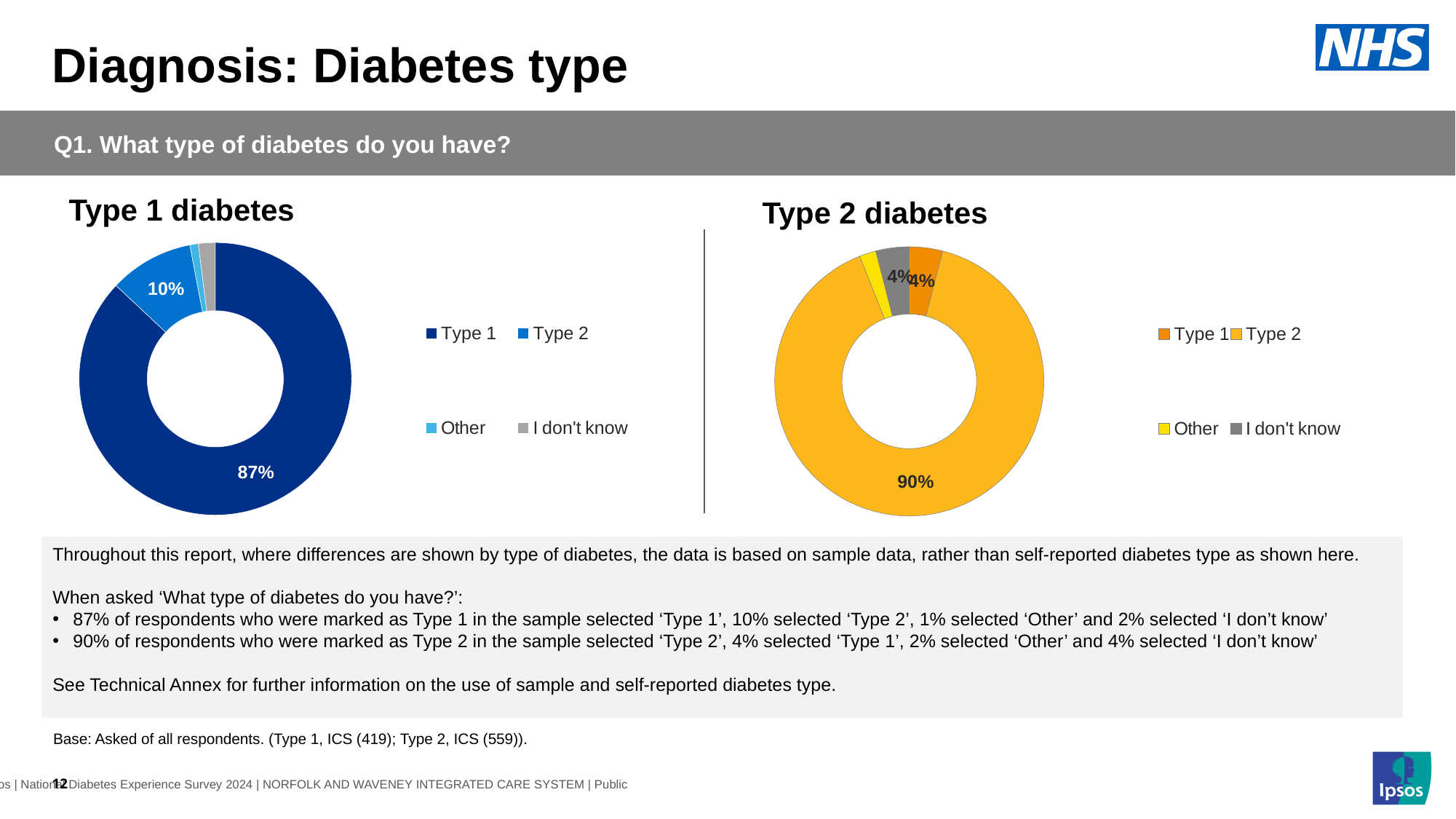
In the 'Type 1 diabetes' chart, what percentage selected 'Type 1'? 87% In the 'Type 1 diabetes' chart, what is the difference between the 'Type 1' and 'Type 2' shares? 77% How many categories does the legend of the 'Type 2 diabetes' chart list? 4 In the 'Type 1 diabetes' chart, which is larger: the 'Type 2' share or the 'Other' share? Type 2 In the 'Type 2 diabetes' chart, what is the difference between the 'Type 2' and 'Type 1' shares? 86% In the 'Type 2 diabetes' chart, what percentage selected 'Type 1'? 4% In the 'Type 1 diabetes' chart, what percentage selected 'Type 2'? 10% What kind of chart is the 'Type 1 diabetes' chart? Doughnut chart In the 'Type 2 diabetes' chart, what percentage selected 'Type 2'? 90% In the 'Type 1 diabetes' chart, which category has the largest share? Type 1 In the 'Type 2 diabetes' chart, which category has the largest share? Type 2 In the 'Type 2 diabetes' chart, what colour represents 'Other'? Yellow